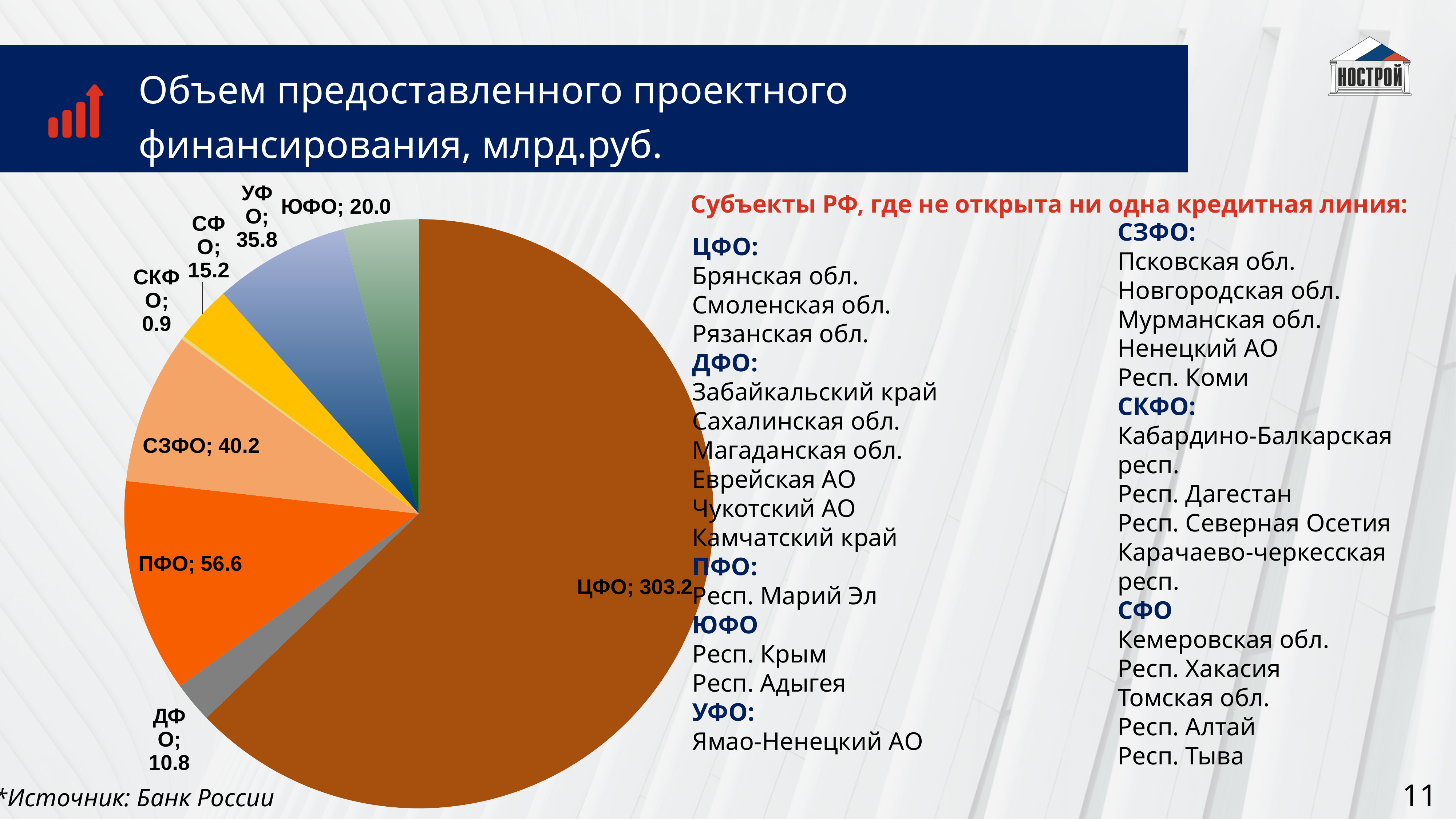
What is the value for СКФО in the pie chart? 0.9 What is the value for УФО in the pie chart? 35.8 Which is larger, the value for ЮФО or the value for СФО? ЮФО Which federal district has the largest slice in the pie chart? ЦФО What is the value for СЗФО in the pie chart? 40.2 Which federal district has the smallest slice in the pie chart? СКФО What is the value for ПФО in the pie chart? 56.6 What kind of chart is shown on the slide? pie chart What is the title of the slide containing the pie chart? Объем предоставленного проектного финансирования, млрд.руб. What is the difference between the values for ПФО and СЗФО? 16.4 How many slices does the pie chart have? 8 What is the value for ЦФО in the pie chart? 303.2